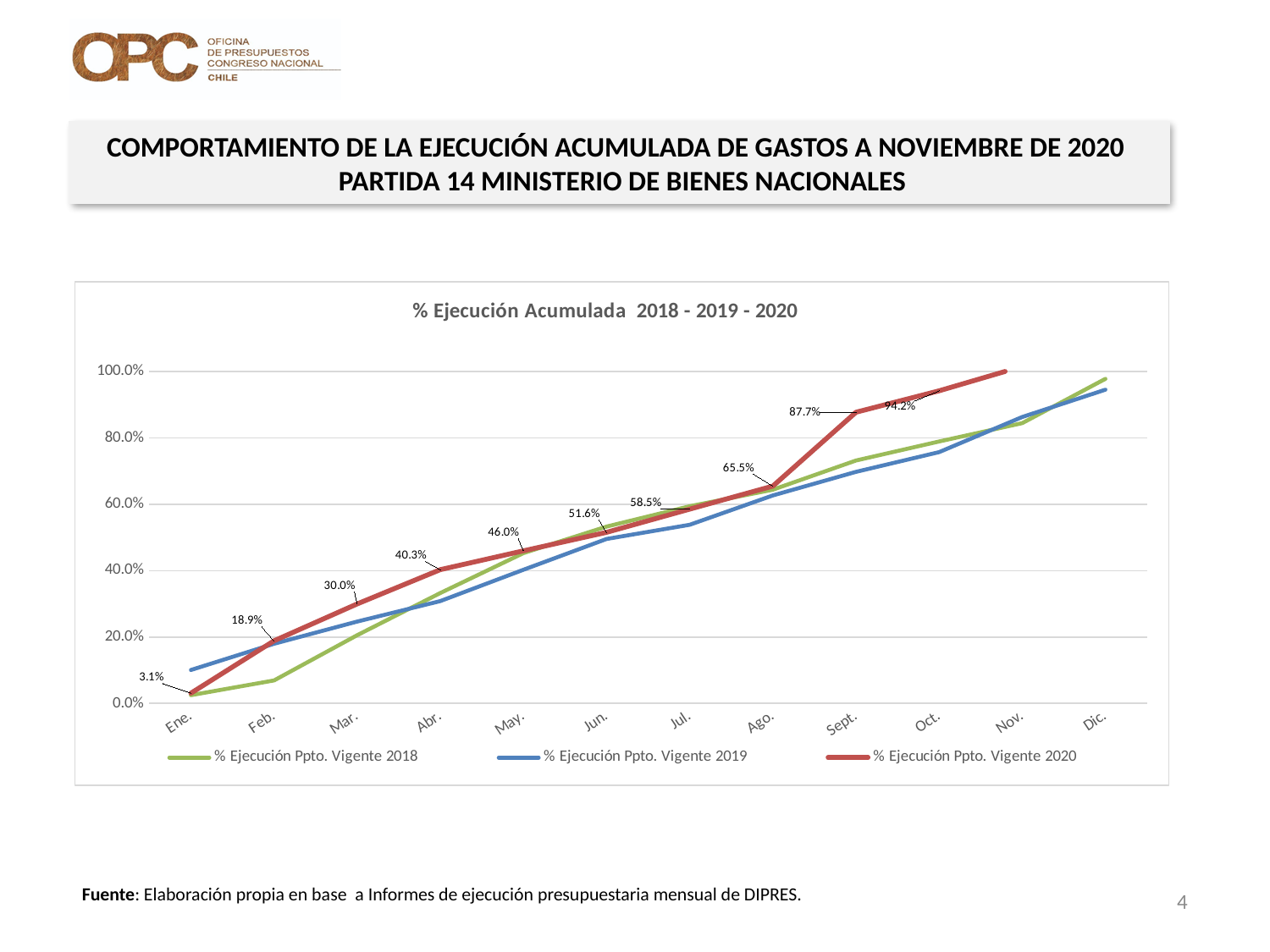
What is the value for % Ejecución Ppto. Vigente 2020 in Sept.? 87.7% What is the title of the chart? % Ejecución Acumulada 2018 - 2019 - 2020 What is the value for % Ejecución Ppto. Vigente 2020 in Ene.? 3.1% Is the value for % Ejecución Ppto. Vigente 2019 in Ene. greater or less than 20.0%? less What is the difference between the % Ejecución Ppto. Vigente 2020 values for Sept. and Ago.? 22.2% In Sept., which series has the larger value, % Ejecución Ppto. Vigente 2020 or % Ejecución Ppto. Vigente 2019? % Ejecución Ppto. Vigente 2020 How many months are shown along the x axis? 12 What is the value for % Ejecución Ppto. Vigente 2020 in Mar.? 30.0% How many series does the legend list? 3 What is the difference between the % Ejecución Ppto. Vigente 2020 values for Oct. and Sept.? 6.5% Does the % Ejecución Ppto. Vigente 2020 line rise or fall from Ene. to Nov.? rise What kind of chart is shown on the slide? line chart